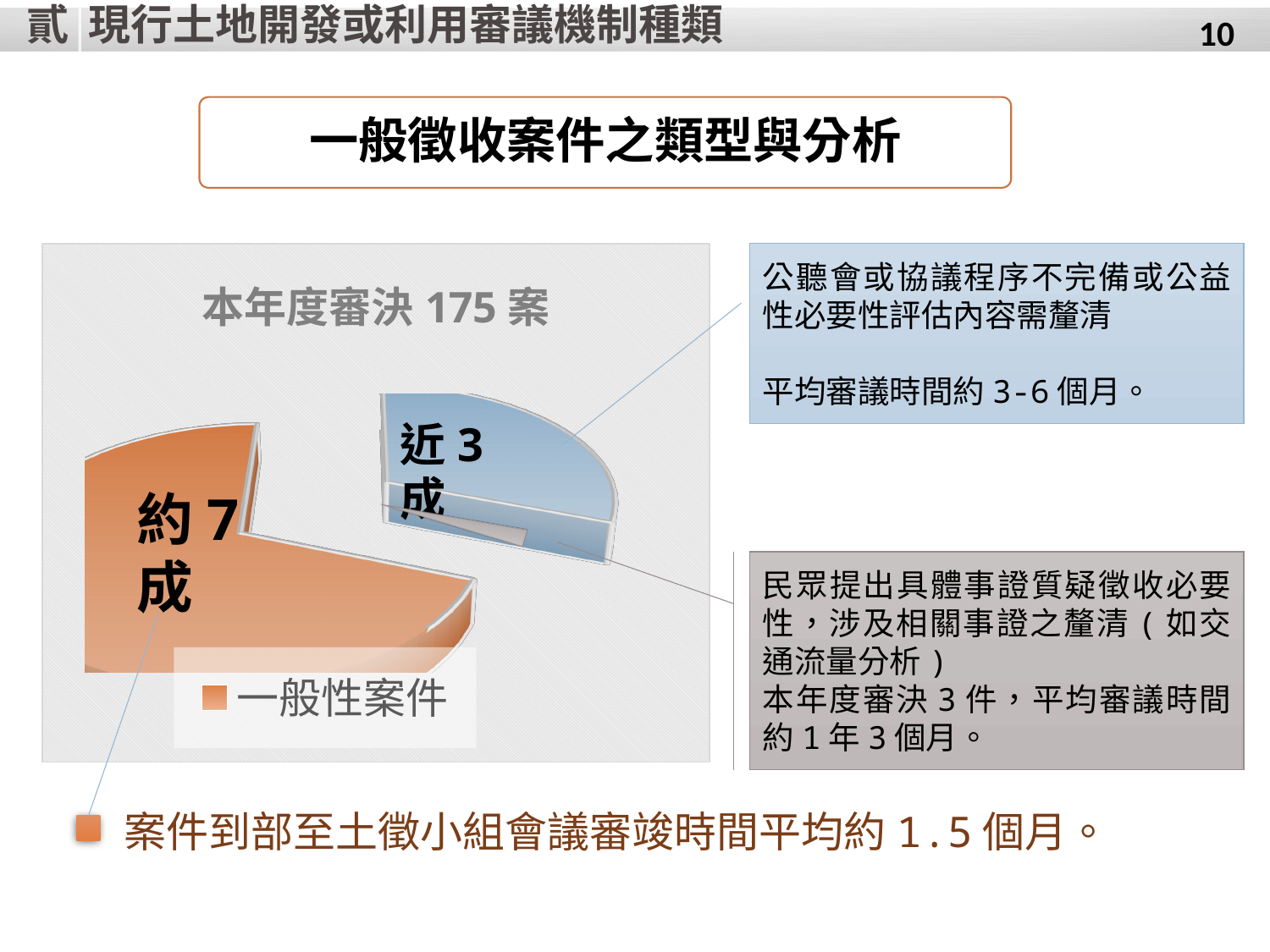
What type of chart is shown on the slide? pie chart Which slice is larger, the one labelled 約 7 成 or the one labelled 近 3 成? 約 7 成 What label is printed on the orange slice of the pie chart? 約 7 成 What label is printed on the blue slice of the pie chart? 近 3 成 Which legend entry is shown for the orange slice of the pie chart? 一般性案件 Is the blue slice of the pie chart larger or smaller than the orange slice? smaller Which slice of the pie chart is the largest? 一般性案件 What is the title of the pie chart? 本年度審決 175 案 How many entries does the pie chart's legend list? 1 How many slices does the pie chart have? 2